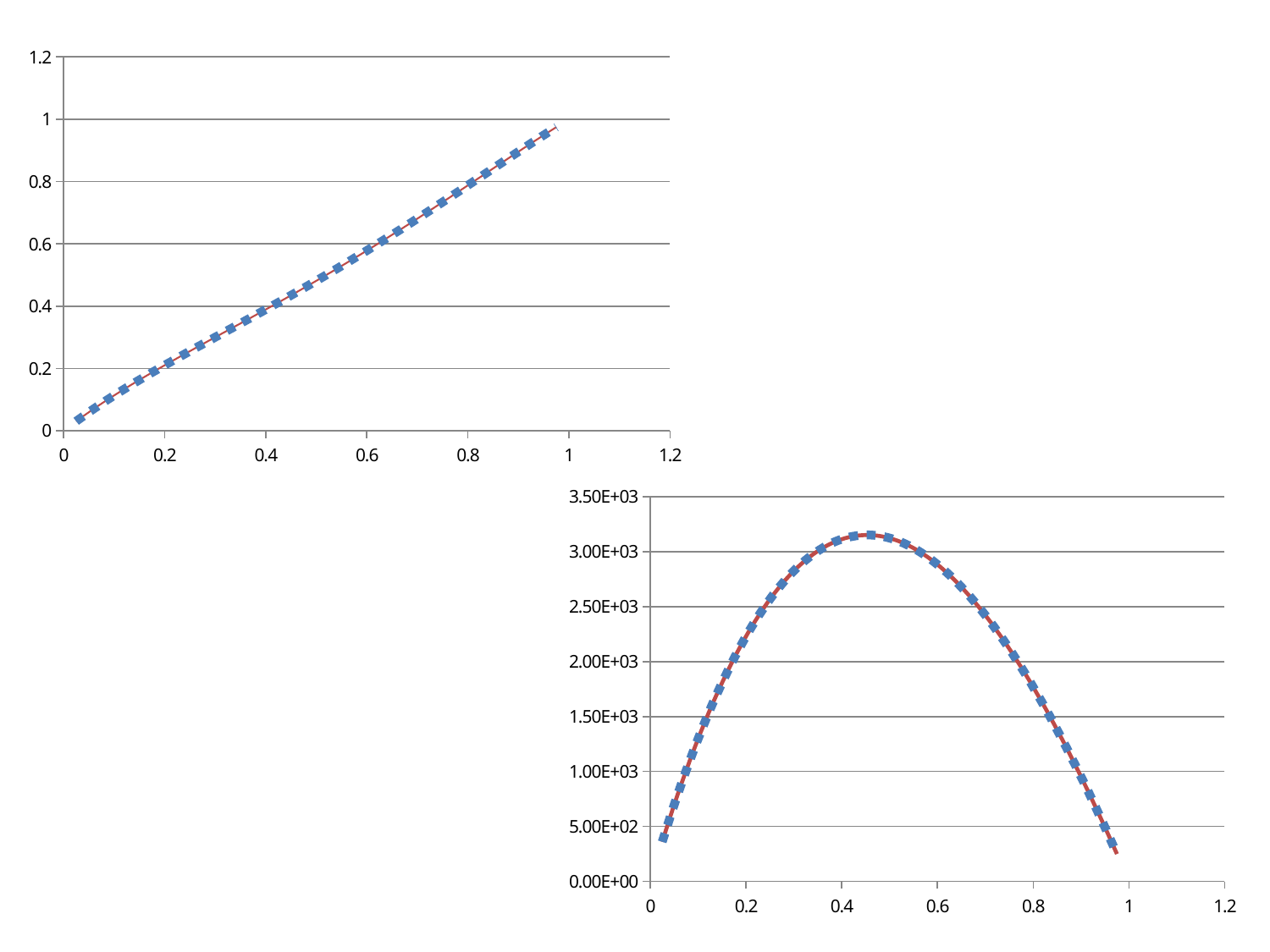
In the top-left chart, which is larger: the value at x = 0.2 or the value at x = 0.8? x = 0.8 In the bottom-right chart, which is larger: the value at x = 0.4 or the value at x = 0.8? x = 0.4 What is the highest tick label on the y axis of the bottom-right chart? 3.50E+03 In the bottom-right chart, is the peak value greater or less than 3.00E+03? greater What kind of chart is the bottom-right chart? line chart What kind of chart is the top-left chart? line chart In the top-left chart, do the values rise or fall as x increases? rise In the bottom-right chart, is the value at x = 0.8 greater or less than 2.00E+03? less In the top-left chart, is the value at x = 0.2 greater or less than 0.4? less In the bottom-right chart, how do the values change as x increases from 0 to 1? rise then fall